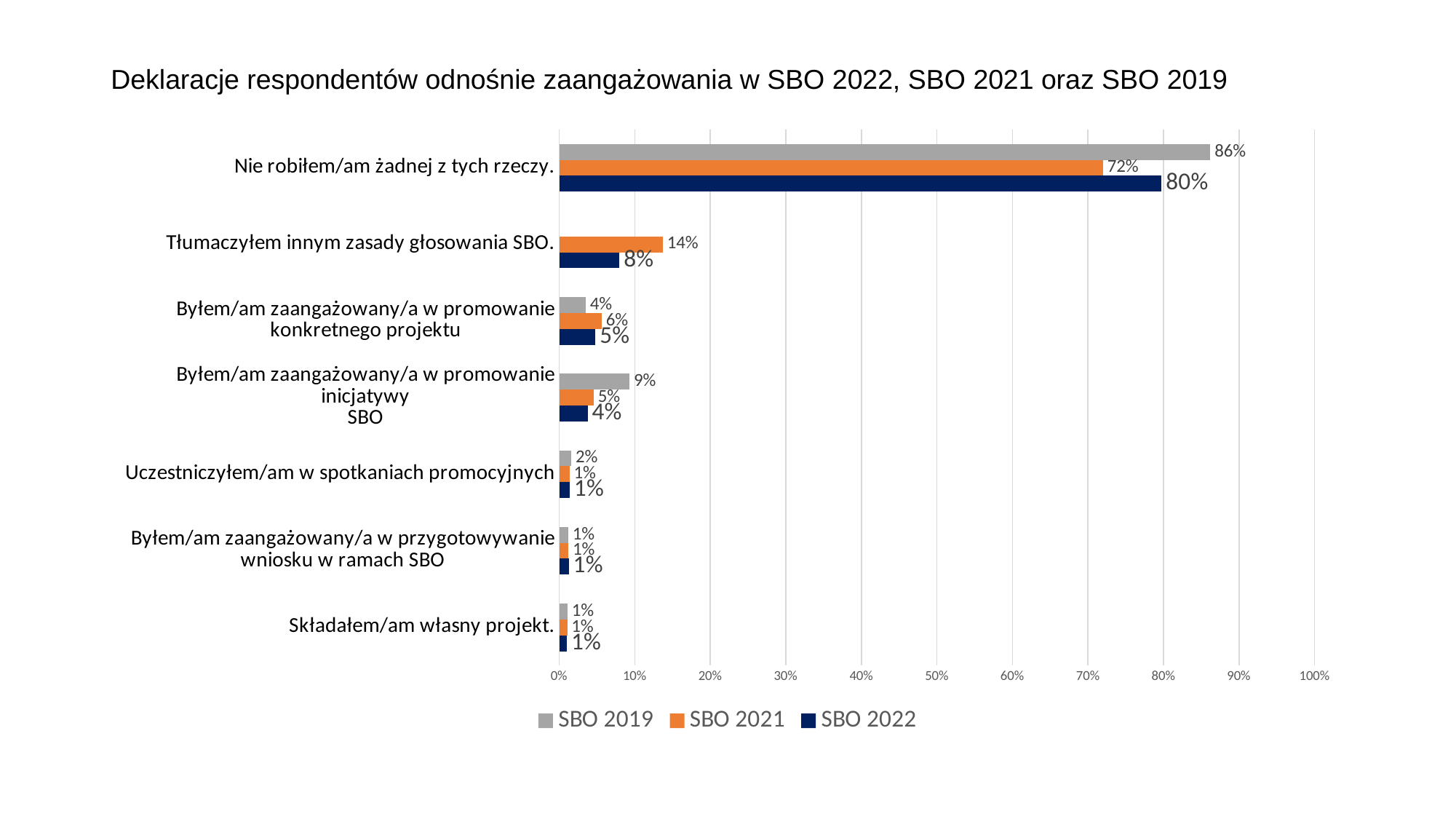
What is the SBO 2021 value for "Byłem/am zaangażowany/a w promowanie konkretnego projektu"? 6% What is the SBO 2021 value for "Tłumaczyłem innym zasady głosowania SBO."? 14% How many categories are shown on the chart? 7 For "Byłem/am zaangażowany/a w promowanie inicjatywy SBO", which is larger: the SBO 2019 value or the SBO 2021 value? SBO 2019 What is the difference between the SBO 2021 and SBO 2022 values for "Tłumaczyłem innym zasady głosowania SBO."? 6% What kind of chart is shown on the slide? Bar chart How many series does the legend list? 3 What is the difference between the SBO 2019 and SBO 2021 values for "Nie robiłem/am żadnej z tych rzeczy."? 14% Which category has the highest SBO 2022 value? Nie robiłem/am żadnej z tych rzeczy. What is the SBO 2022 value for "Byłem/am zaangażowany/a w promowanie inicjatywy SBO"? 4% What is the SBO 2019 value for "Nie robiłem/am żadnej z tych rzeczy."? 86% Is the SBO 2022 value for "Nie robiłem/am żadnej z tych rzeczy." greater or less than 70%? greater